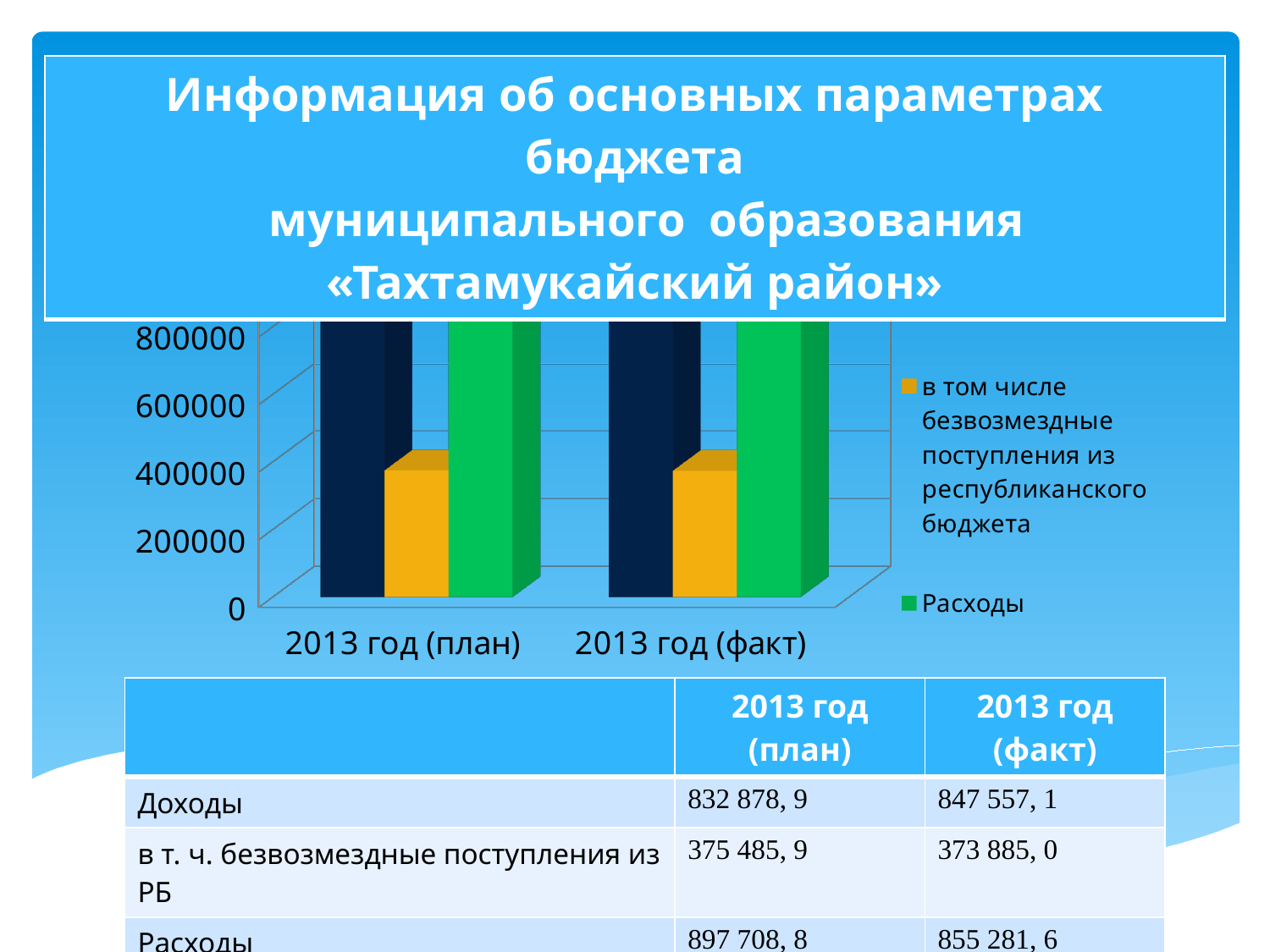
For 2013 год (план), which is larger: Расходы or безвозмездные поступления из республиканского бюджета? Расходы Which series has the lowest bar for 2013 год (факт)? в том числе безвозмездные поступления из республиканского бюджета Is the value of the green bar (Расходы) for 2013 год (план) greater or less than 800000? greater Is the value of the yellow bar (безвозмездные поступления из республиканского бюджета) for 2013 год (факт) greater or less than 200000? greater What are the two categories on the x axis of the chart? 2013 год (план) and 2013 год (факт) According to the table under the chart, what is the value of Расходы for 2013 год (план)? 897 708, 8 According to the table under the chart, what is the value of Доходы for 2013 год (факт)? 847 557, 1 Is the value of the green bar (Расходы) for 2013 год (факт) greater or less than 600000? greater How many categories are shown on the x axis of the chart? 2 Which series is shown in green in the chart? Расходы What kind of chart is shown on the slide? bar chart